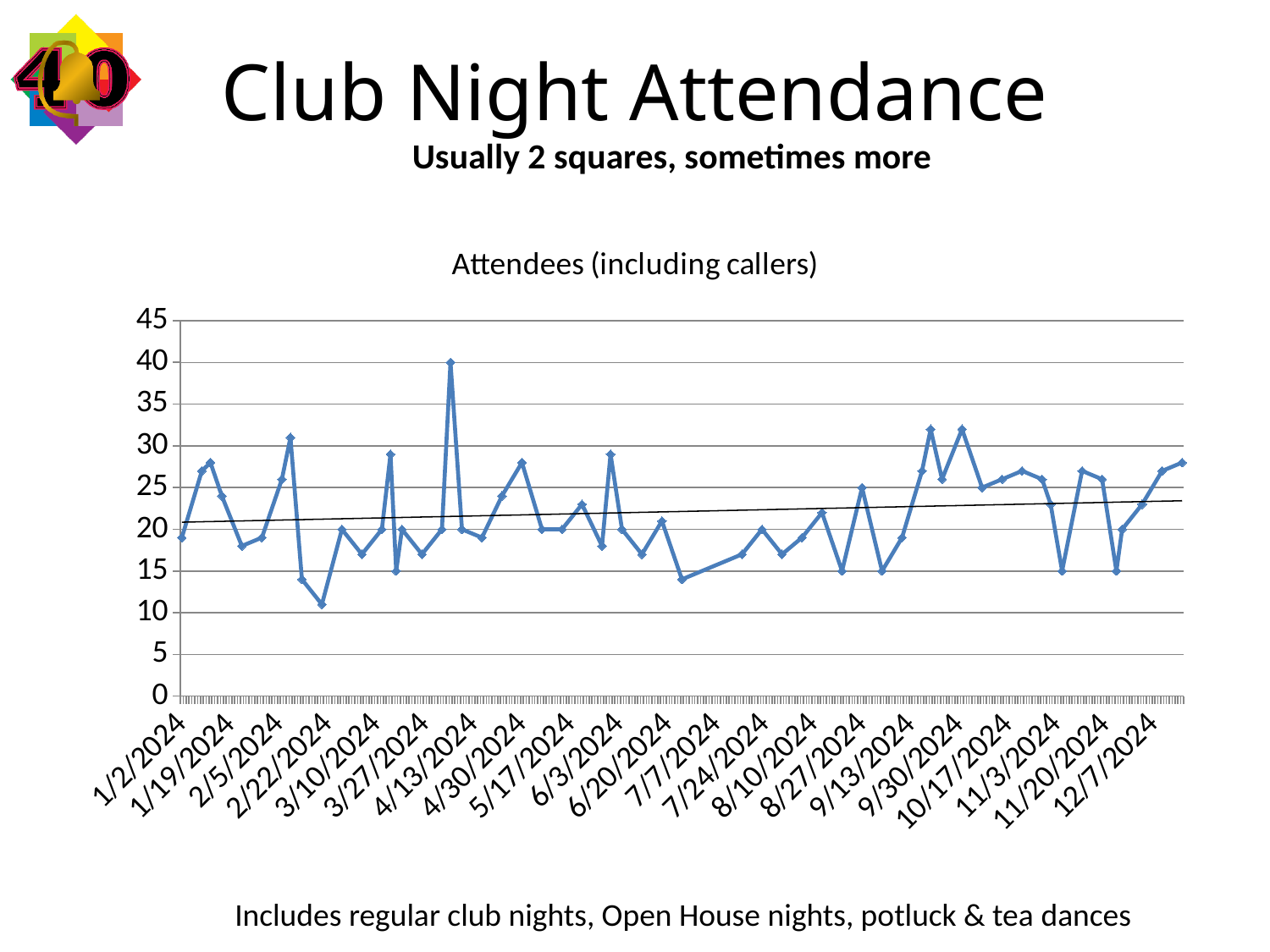
What is the highest value shown on the vertical axis of the chart? 45 Is the attendance value for 1/2/2024 greater or less than 25? less What is the title of the chart? Attendees (including callers) Is the lowest attendance value plotted on the chart greater or less than 15? less Is the highest attendance value plotted on the chart greater or less than 35? greater How many date labels are shown along the horizontal axis of the chart? 21 According to the straight trend line drawn on the chart, does attendance rise or fall over the course of 2024? rise What kind of chart is shown on the slide? line chart Which date label on the horizontal axis comes first? 1/2/2024